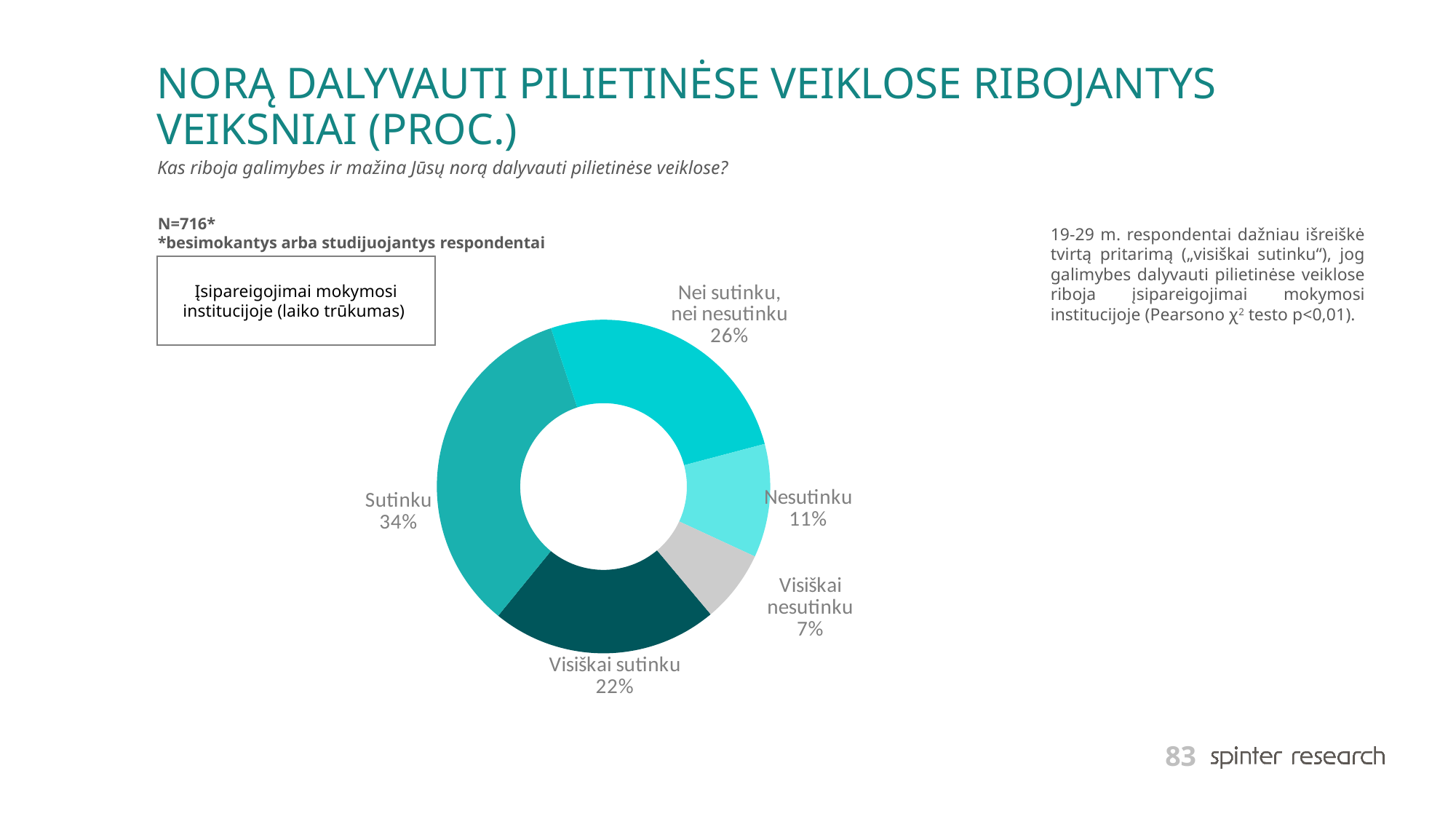
What percentage of respondents answered "Nesutinku"? 11% What is the combined share of "Sutinku" and "Visiškai sutinku"? 56% Which response category has the smallest share? Visiškai nesutinku Which response category has the largest share? Sutinku How many response categories are shown in the chart? 5 What percentage of respondents answered "Nei sutinku, nei nesutinku"? 26% What percentage of respondents answered "Visiškai sutinku"? 22% What percentage of respondents answered "Sutinku"? 34% What is the difference in percentage points between "Sutinku" and "Visiškai sutinku"? 12 What kind of chart is shown on the slide? Doughnut (pie) chart What percentage of respondents answered "Visiškai nesutinku"? 7% Which is larger, the share for "Nei sutinku, nei nesutinku" or the share for "Visiškai sutinku"? Nei sutinku, nei nesutinku